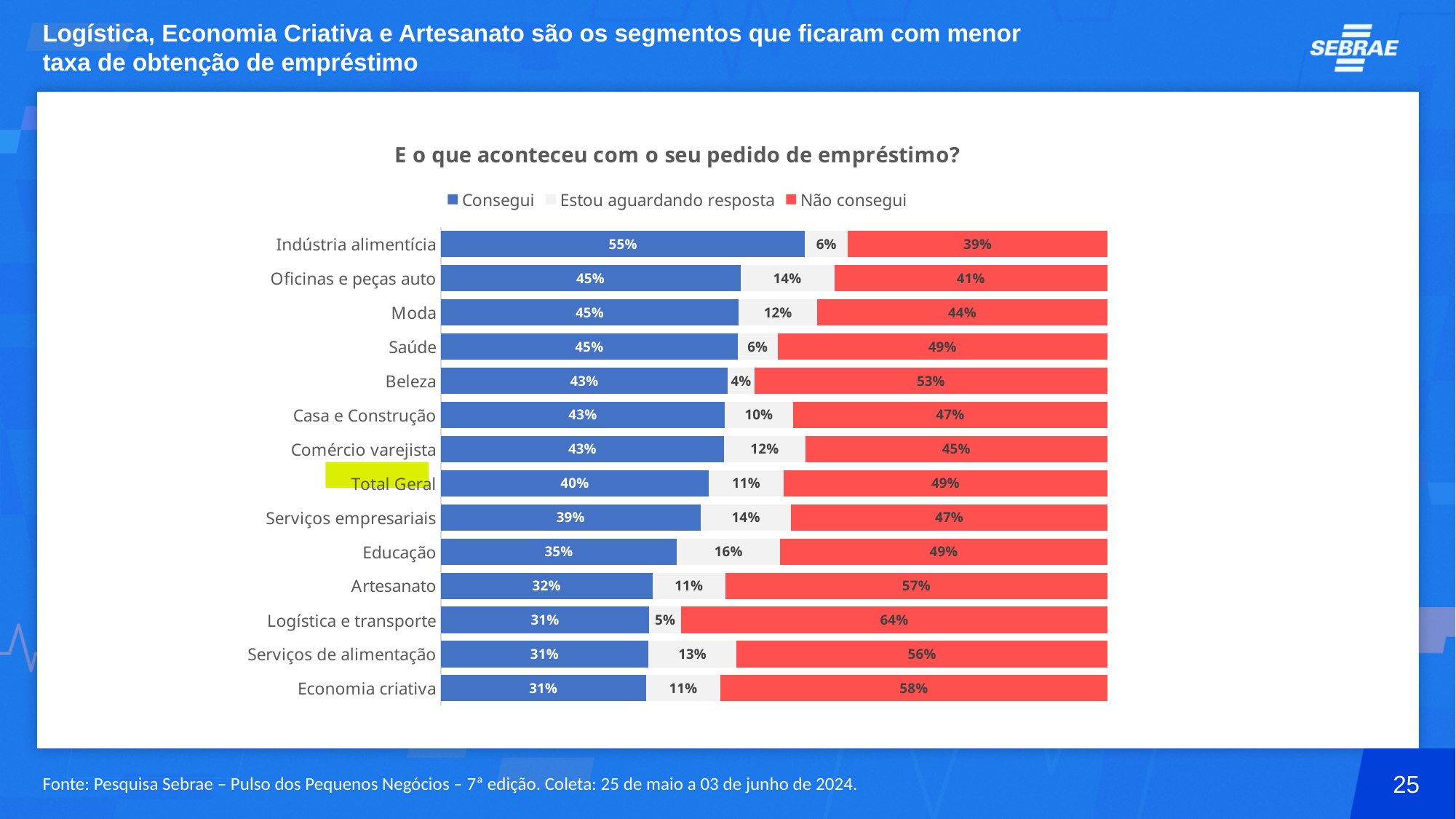
How many series does the legend list? 3 What is the title of the chart? E o que aconteceu com o seu pedido de empréstimo? Which has a larger "Consegui" value, Moda or Educação? Moda Which category has the highest "Consegui" value? Indústria alimentícia Which category has the lowest "Estou aguardando resposta" value? Beleza What is the "Estou aguardando resposta" value for Educação? 16% What percentage of respondents in Indústria alimentícia answered "Consegui"? 55% What is the difference in percentage points between the "Consegui" value for Indústria alimentícia and for Total Geral? 15 percentage points Which category has the highest "Não consegui" value? Logística e transporte How many categories are shown on the chart? 14 What kind of chart is shown on the slide? Stacked bar chart What is the "Não consegui" value for Logística e transporte? 64%